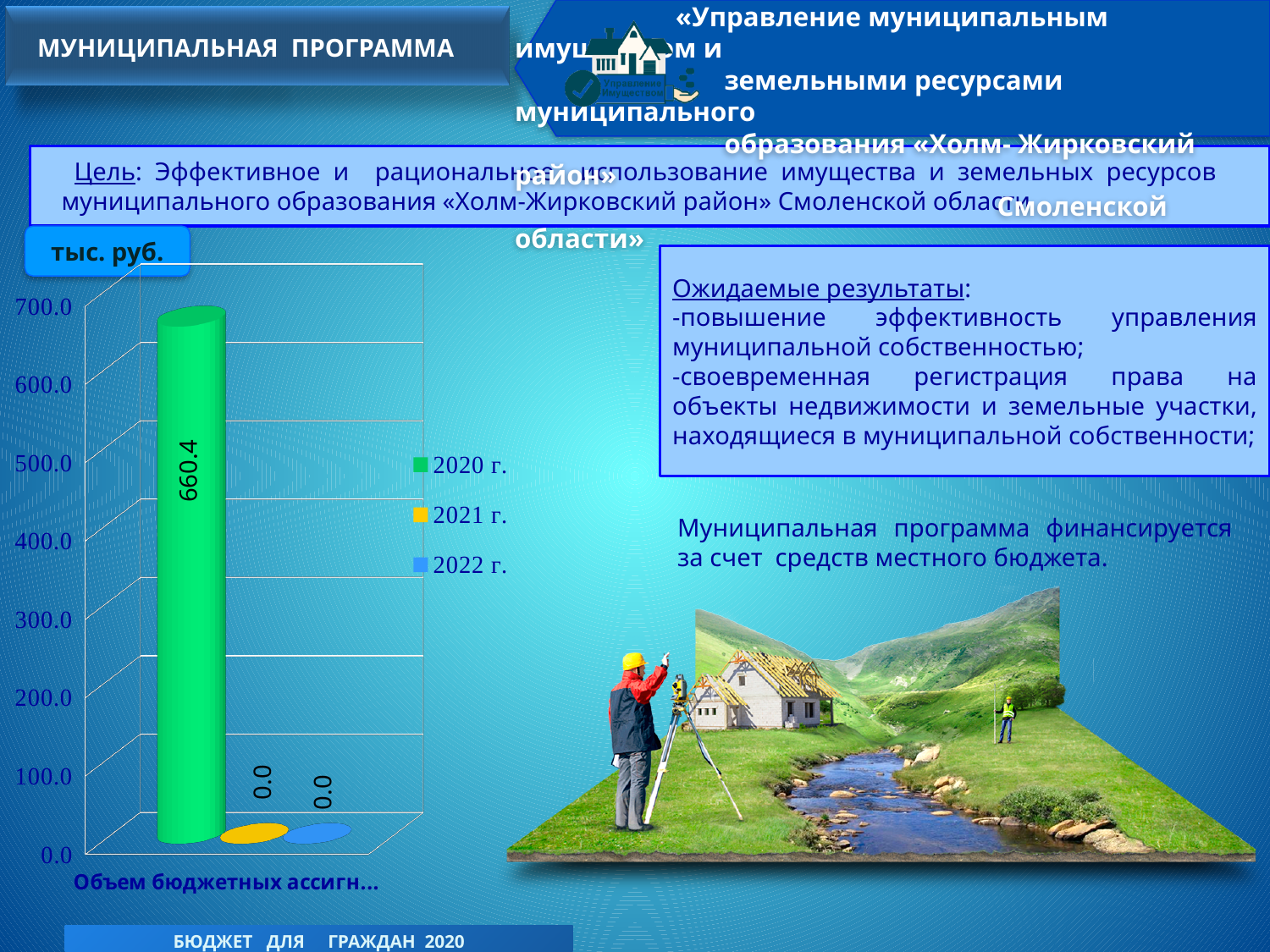
What is the value for the 2022 г. series on the chart? 0.0 Is the value for 2020 г. greater or less than 600.0? greater What kind of chart is shown on the slide? bar chart What colour is the bar for the 2020 г. series? green Is the value for 2020 г. greater or less than 700.0? less Which series has the highest value on the chart? 2020 г. What is the value for the 2020 г. series on the chart? 660.4 How many series does the chart legend list? 3 What is the difference between the 2020 г. value and the 2021 г. value? 660.4 Which is larger, the value for 2020 г. or the value for 2022 г.? 2020 г. What unit of measurement is indicated for the chart values? тыс. руб. What is the value for the 2021 г. series on the chart? 0.0